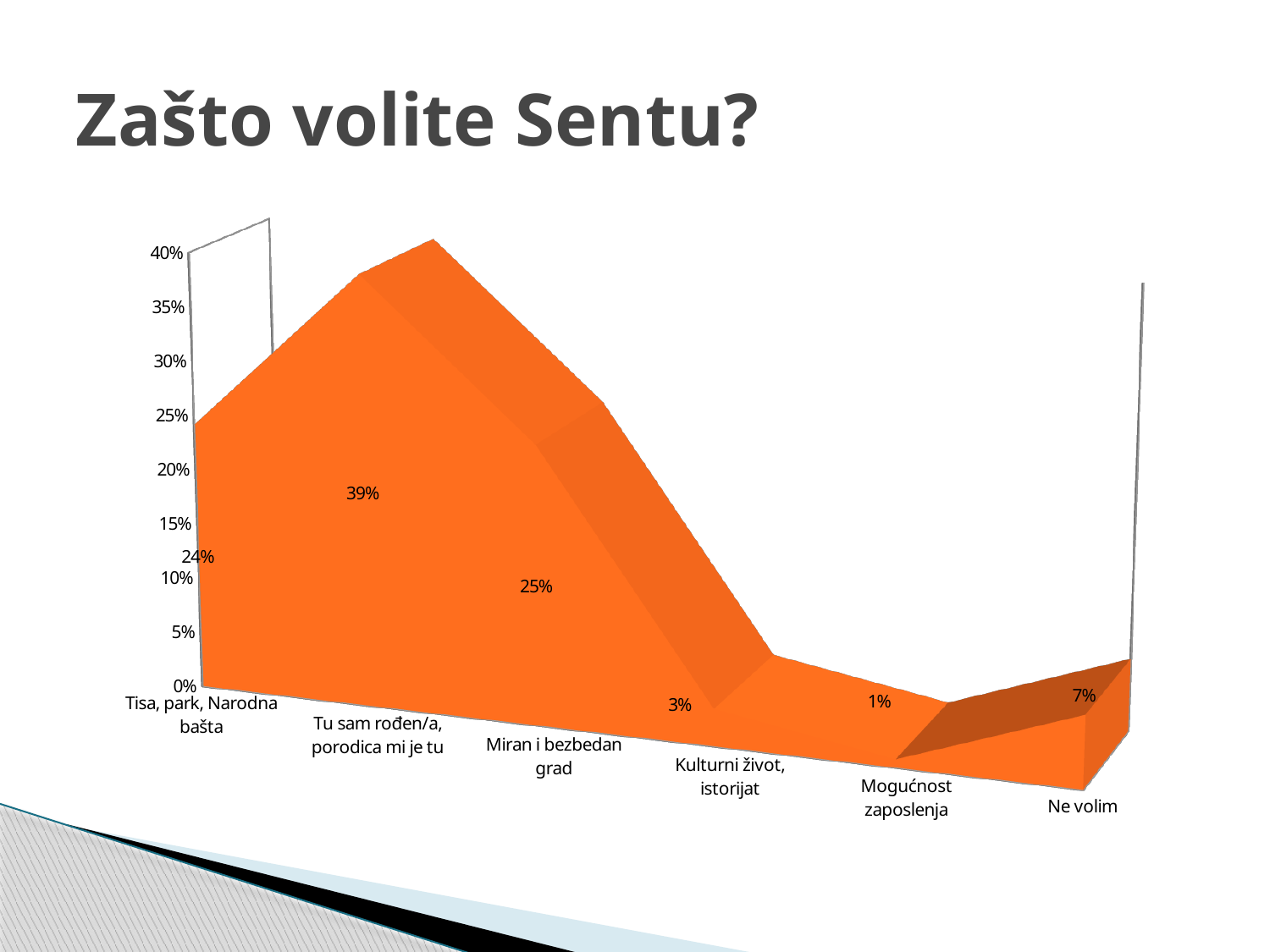
How many categories are shown on the x axis? 6 What is the value for "Miran i bezbedan grad"? 25% Which is larger, the value for "Ne volim" or the value for "Kulturni život, istorijat"? Ne volim Which category has the highest value? Tu sam rođen/a, porodica mi je tu What is the value for "Mogućnost zaposlenja"? 1% What is the value for "Tisa, park, Narodna bašta"? 24% What is the value for "Tu sam rođen/a, porodica mi je tu"? 39% What is the difference between the values for "Tu sam rođen/a, porodica mi je tu" and "Miran i bezbedan grad"? 14% What is the title of the slide containing the chart? Zašto volite Sentu? Which category has the lowest value? Mogućnost zaposlenja What kind of chart is shown on the slide? Area chart What is the value for "Ne volim"? 7%